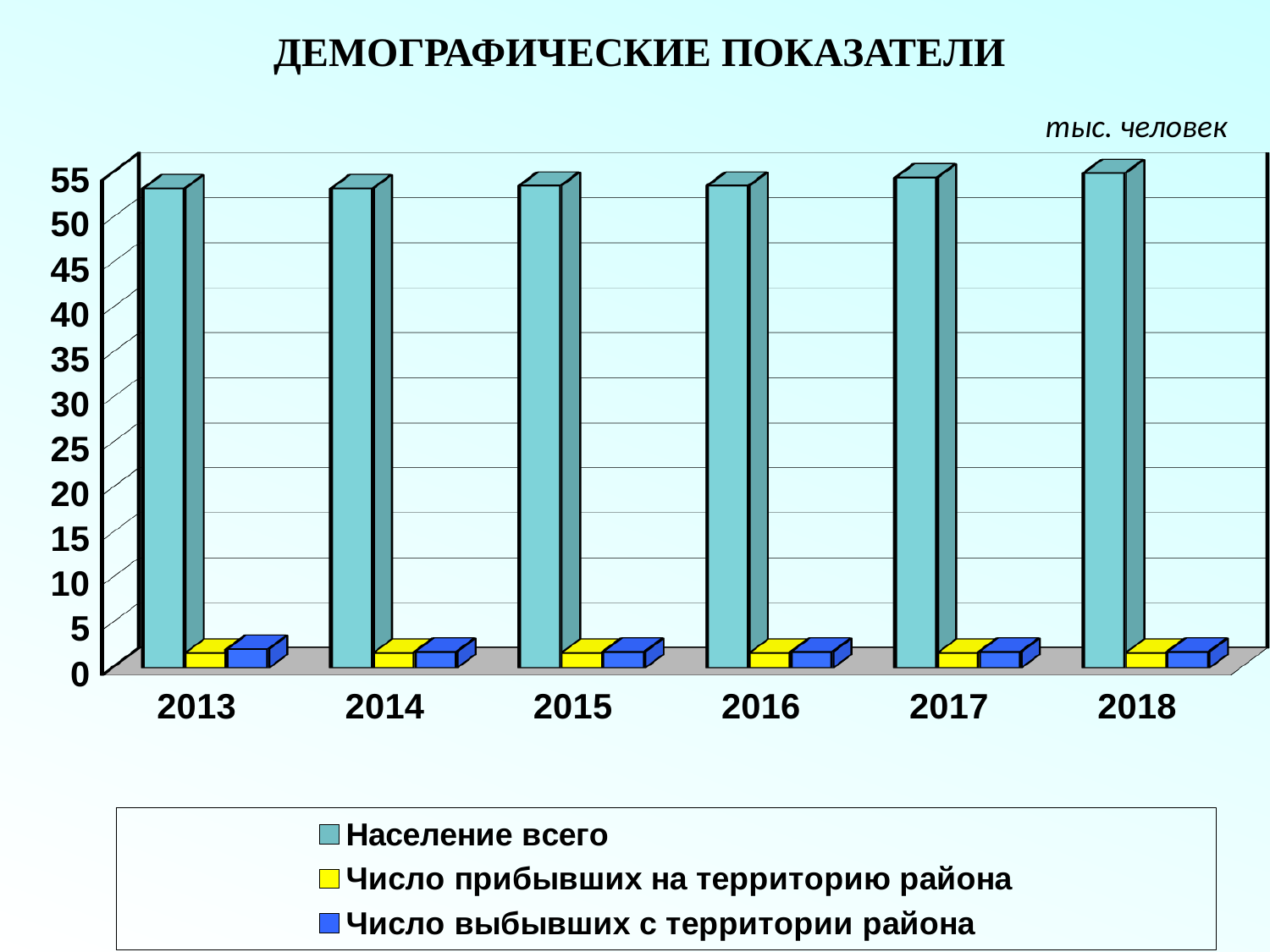
What kind of chart is shown on the slide? bar chart What unit is indicated above the chart? тыс. человек Is the value for Число выбывших с территории района in 2017 greater or less than 10? less Is the value for Население всего in 2018 greater or less than 45? greater Is the value for Население всего in 2013 greater or less than 50? greater Which is larger in 2016: Население всего or Число прибывших на территорию района? Население всего What is the title of the chart? ДЕМОГРАФИЧЕСКИЕ ПОКАЗАТЕЛИ How many series does the legend list? 3 Which series has the lowest values across all years: Население всего or Число выбывших с территории района? Число выбывших с территории района How many years are shown on the x axis of the chart? 6